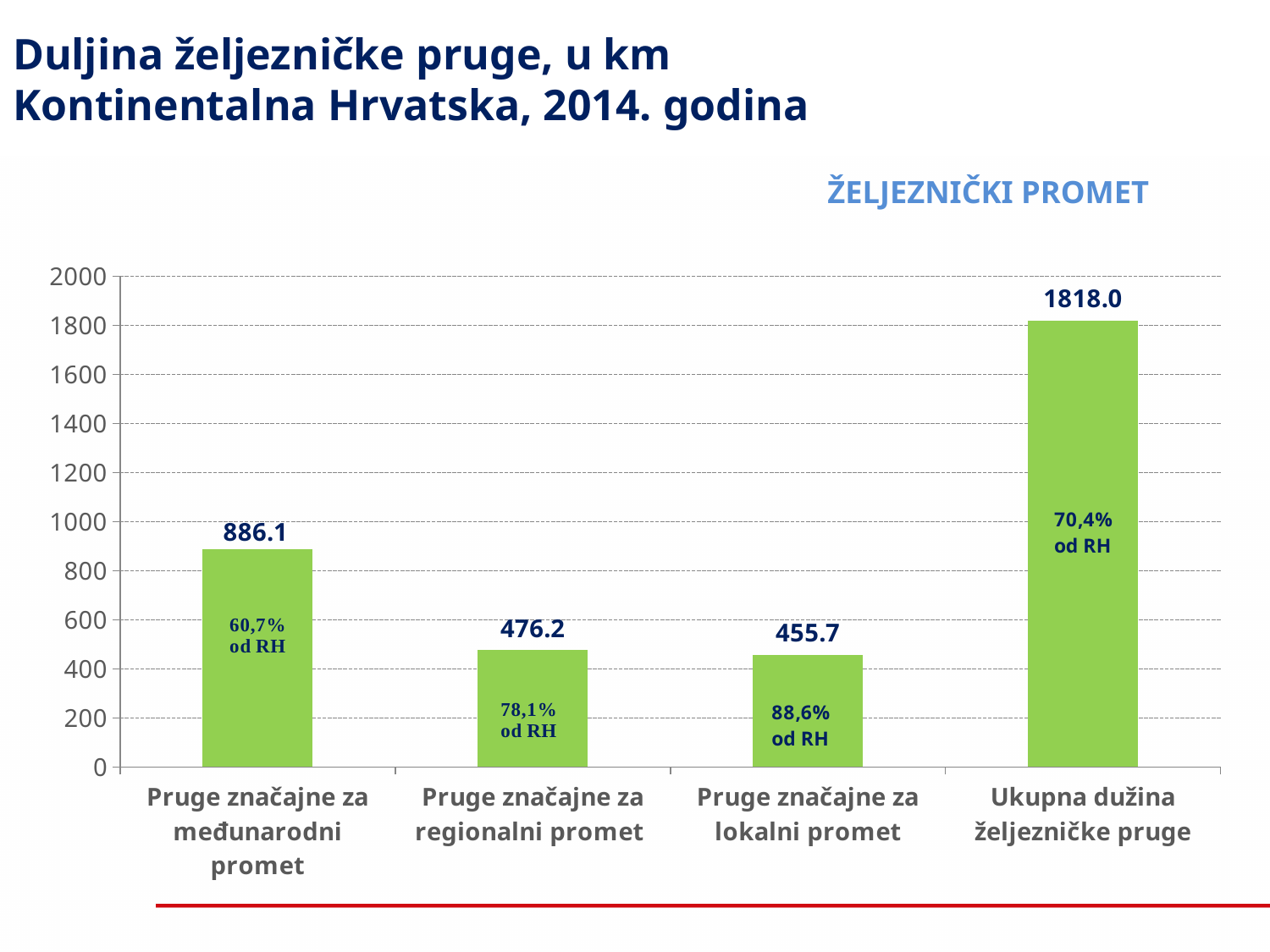
What is the value for 'Ukupna dužina željezničke pruge'? 1818.0 What is the difference between the values for 'Pruge značajne za međunarodni promet' and 'Pruge značajne za regionalni promet'? 409.9 What is the value for 'Pruge značajne za regionalni promet'? 476.2 Which is larger, the value for 'Pruge značajne za regionalni promet' or 'Pruge značajne za lokalni promet'? Pruge značajne za regionalni promet Which category has the lowest value? Pruge značajne za lokalni promet What kind of chart is shown on the slide? bar chart Which category has the highest value? Ukupna dužina željezničke pruge What is the value for 'Pruge značajne za međunarodni promet'? 886.1 How many categories are shown on the x axis? 4 What is the value for 'Pruge značajne za lokalni promet'? 455.7 What is the title of the slide? Duljina željezničke pruge, u km Kontinentalna Hrvatska, 2014. godina What percentage 'od RH' is printed inside the bar for 'Ukupna dužina željezničke pruge'? 70,4%